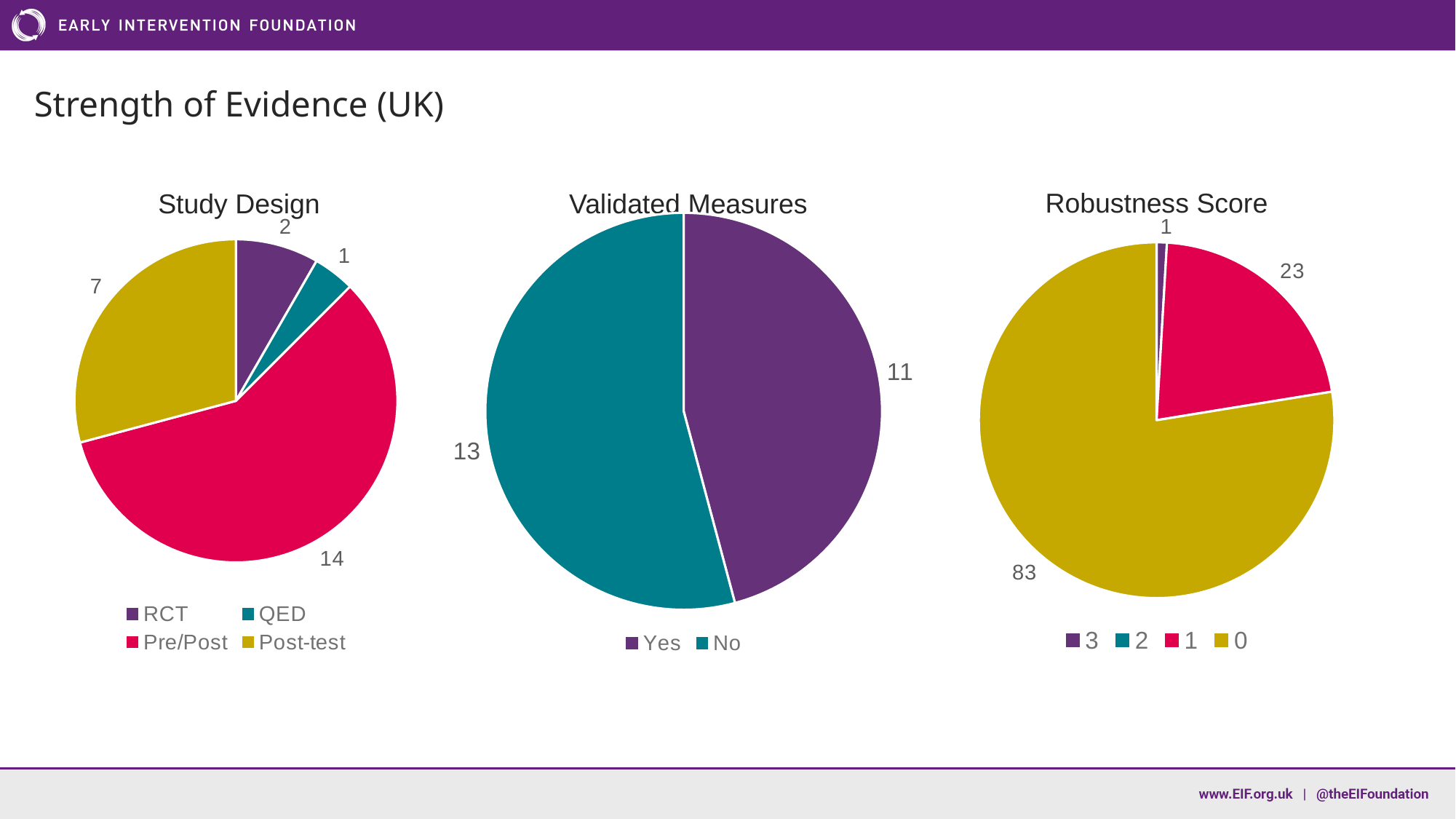
In the Validated Measures chart, what is the difference between No and Yes? 2 In the Robustness Score chart, what is the difference between score 0 and score 1? 60 In the Validated Measures chart, which is larger, Yes or No? No In the Study Design chart, what is the difference between Pre/Post and Post-test? 7 In the Study Design chart, what is the value for QED? 1 In the Robustness Score chart, what is the value for score 0? 83 In the Study Design chart, which category has the largest slice? Pre/Post How many entries does the legend of the Robustness Score chart list? 4 In the Validated Measures chart, what is the value for No? 13 In the Study Design chart, what is the value for Pre/Post? 14 In the Study Design chart, which category has the smallest slice? QED What kind of chart is the Validated Measures chart? Pie chart